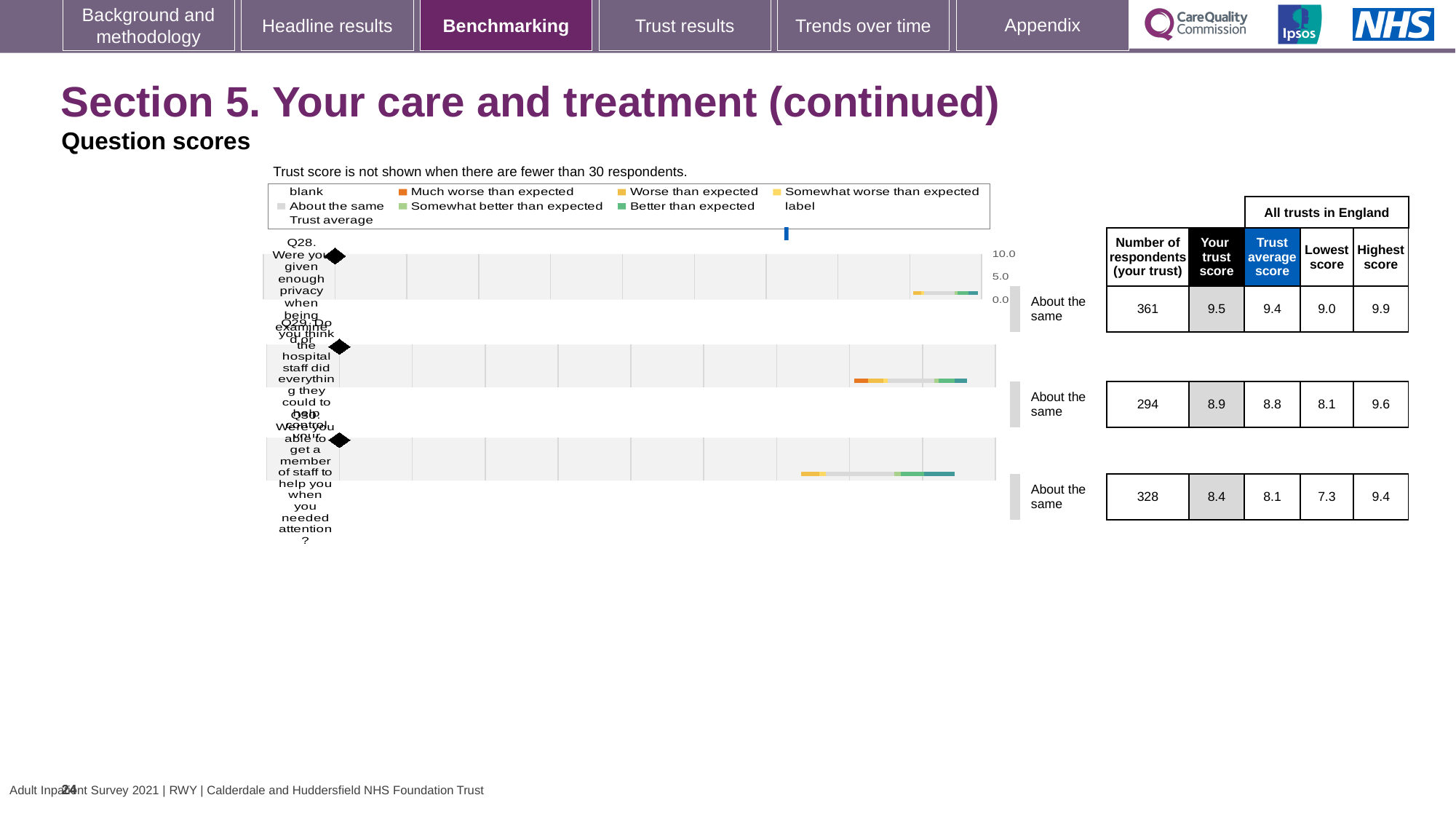
Which question has the highest 'Your trust score' on this slide? Q28 What benchmark category is shown next to the Q29 chart? About the same What is the lowest score across all trusts in England for Q30? 7.3 What is the 'Your trust score' value for Q29 (staff did everything to help control pain)? 8.9 How many respondents does the table show for Q28 (privacy when being examined or treated)? 361 Which is larger: the trust score for Q28 or the trust score for Q29? Q28 Is the trust score for Q28 greater or less than 5.0? greater Which question has the fewest respondents? Q29 What is the trust average score for Q30 (able to get a member of staff to help when needed)? 8.1 For Q30, what is the difference between 'Your trust score' and the trust average score? 0.3 What is the highest score across all trusts in England for Q28? 9.9 How many questions are plotted on this slide? 3